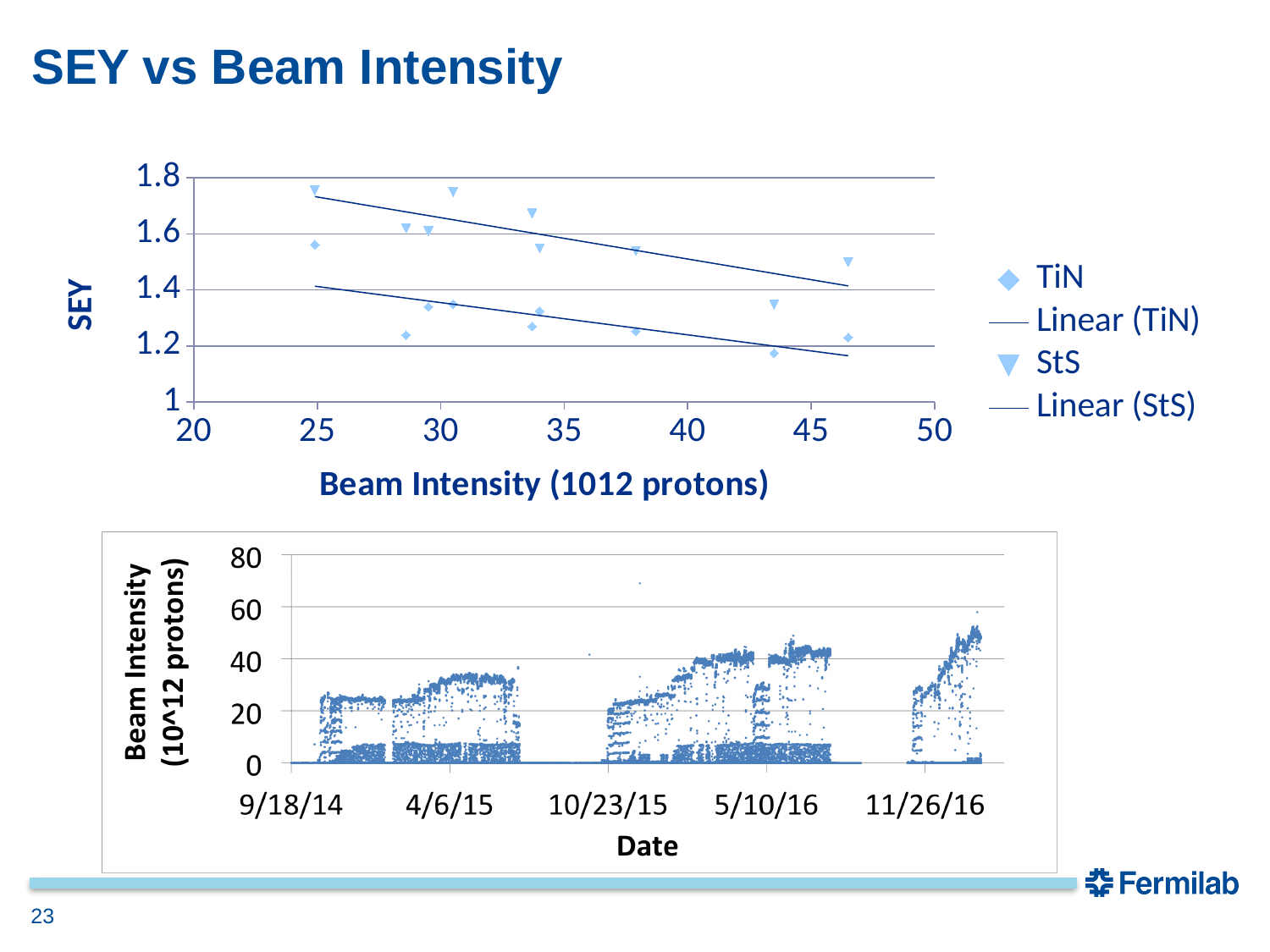
In the top chart, how many entries does the legend list? 4 In the top chart, is the SEY value for TiN at a beam intensity of about 38 greater or less than 1.4? less In the bottom chart, does the beam intensity plateau generally rise or fall from 9/18/14 to 11/26/16? rise In the bottom chart, what is the label of the y axis? Beam Intensity (10^12 protons) In the top chart, does SEY rise or fall as beam intensity increases, according to the linear fit lines? fall In the top chart, is the SEY value for TiN at a beam intensity of about 25 greater or less than 1.4? greater In the top chart, what is the label of the x axis? Beam Intensity (1012 protons) What kind of chart is the top chart, 'SEY vs Beam Intensity'? scatter chart In the top chart, is the SEY value for StS at a beam intensity of about 25 greater or less than 1.6? greater In the top chart, which series has the higher SEY values overall, TiN or StS? StS In the top chart, what are the two data series named in the legend (excluding the linear fits)? TiN and StS